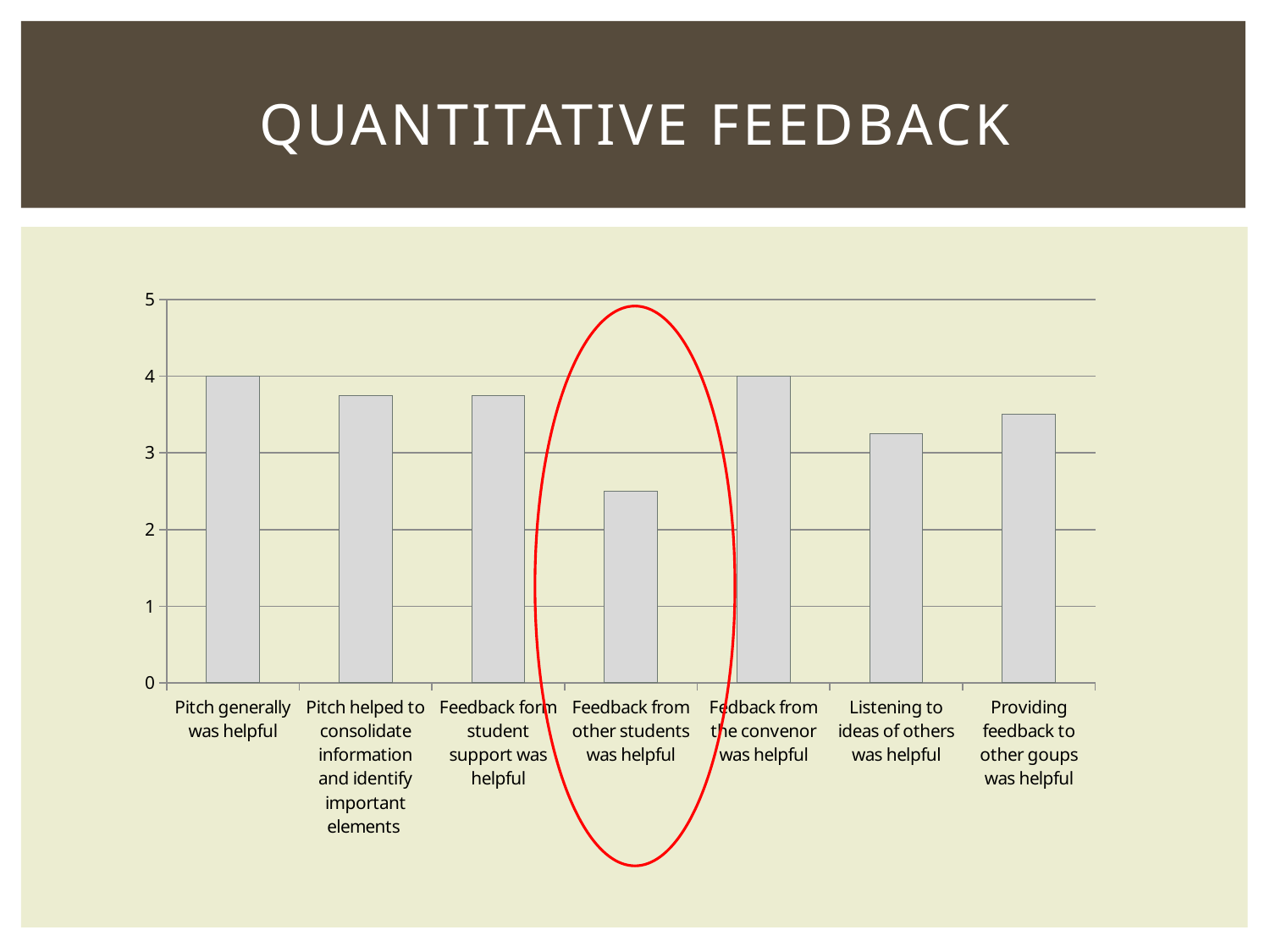
What is the value for "Feedback from the convenor was helpful"? 4 Which is larger: the value for "Feedback from other students was helpful" or the value for "Providing feedback to other goups was helpful"? Providing feedback to other goups was helpful Is the value for "Feedback from other students was helpful" greater or less than 3? less What is the value for "Pitch generally was helpful"? 4 What is the title of the slide containing the chart? QUANTITATIVE FEEDBACK Is the value for "Listening to ideas of others was helpful" greater or less than 3? greater What kind of chart is shown on the slide? bar chart Is the value for "Pitch helped to consolidate information and identify important elements" greater or less than 3? greater Which category has the lowest value? Feedback from other students was helpful Which bar is circled in red on the chart? Feedback from other students was helpful How many categories are plotted in the chart? 7